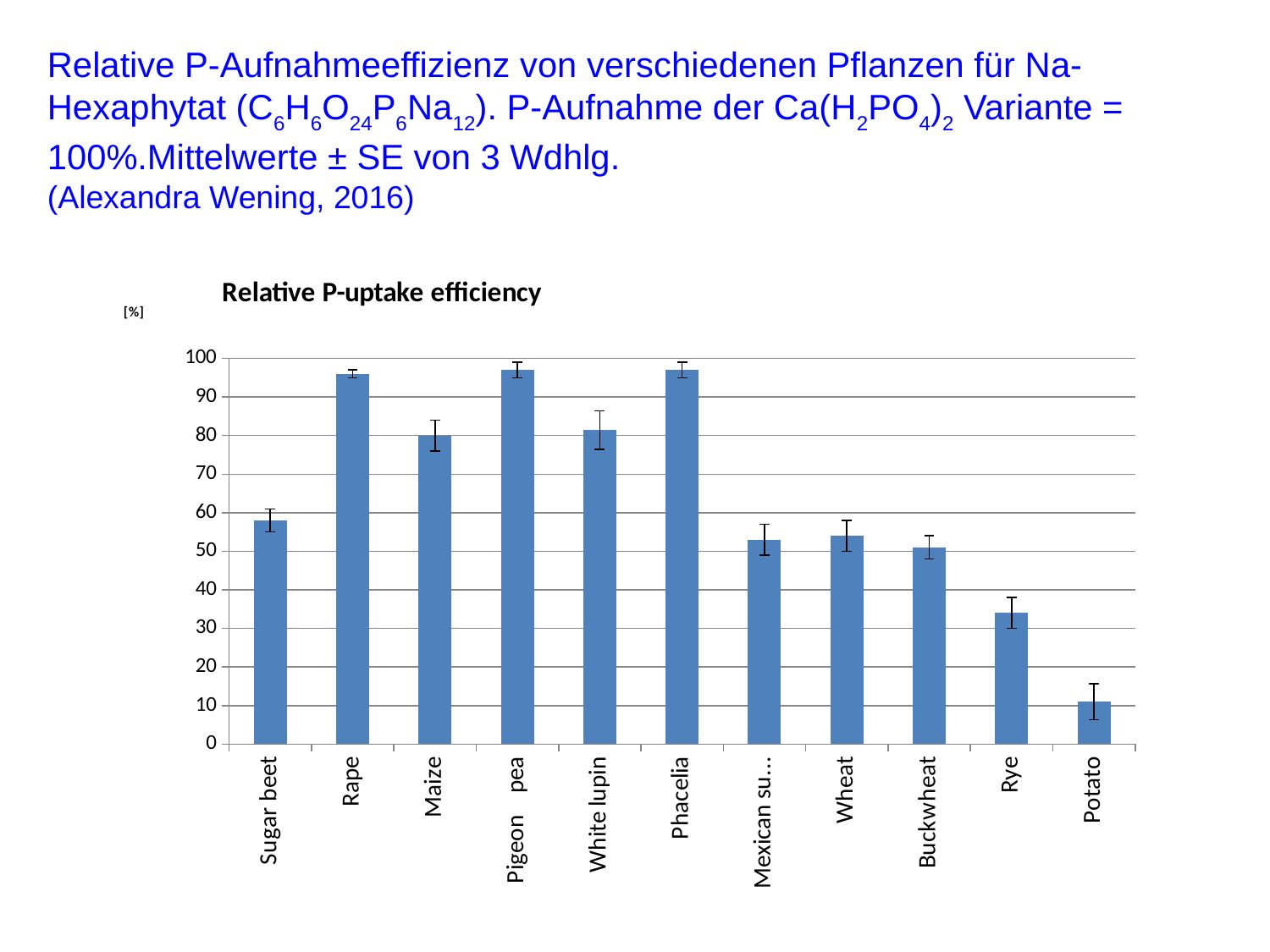
Which plant has the lowest relative P-uptake efficiency? Potato Do the values rise or fall across the last four categories, from Wheat to Potato? fall What unit is shown on the y axis of the chart? [%] What is the title of the chart? Relative P-uptake efficiency Is the value for Rape greater or less than 90? greater Is the value for Rye greater or less than 40? less How many plant categories are plotted in the chart? 11 Which has the larger relative P-uptake efficiency, Rape or Maize? Rape Is the value for Sugar beet greater or less than 50? greater Which has the larger relative P-uptake efficiency, Rye or Sugar beet? Sugar beet What kind of chart is shown on the slide? bar chart